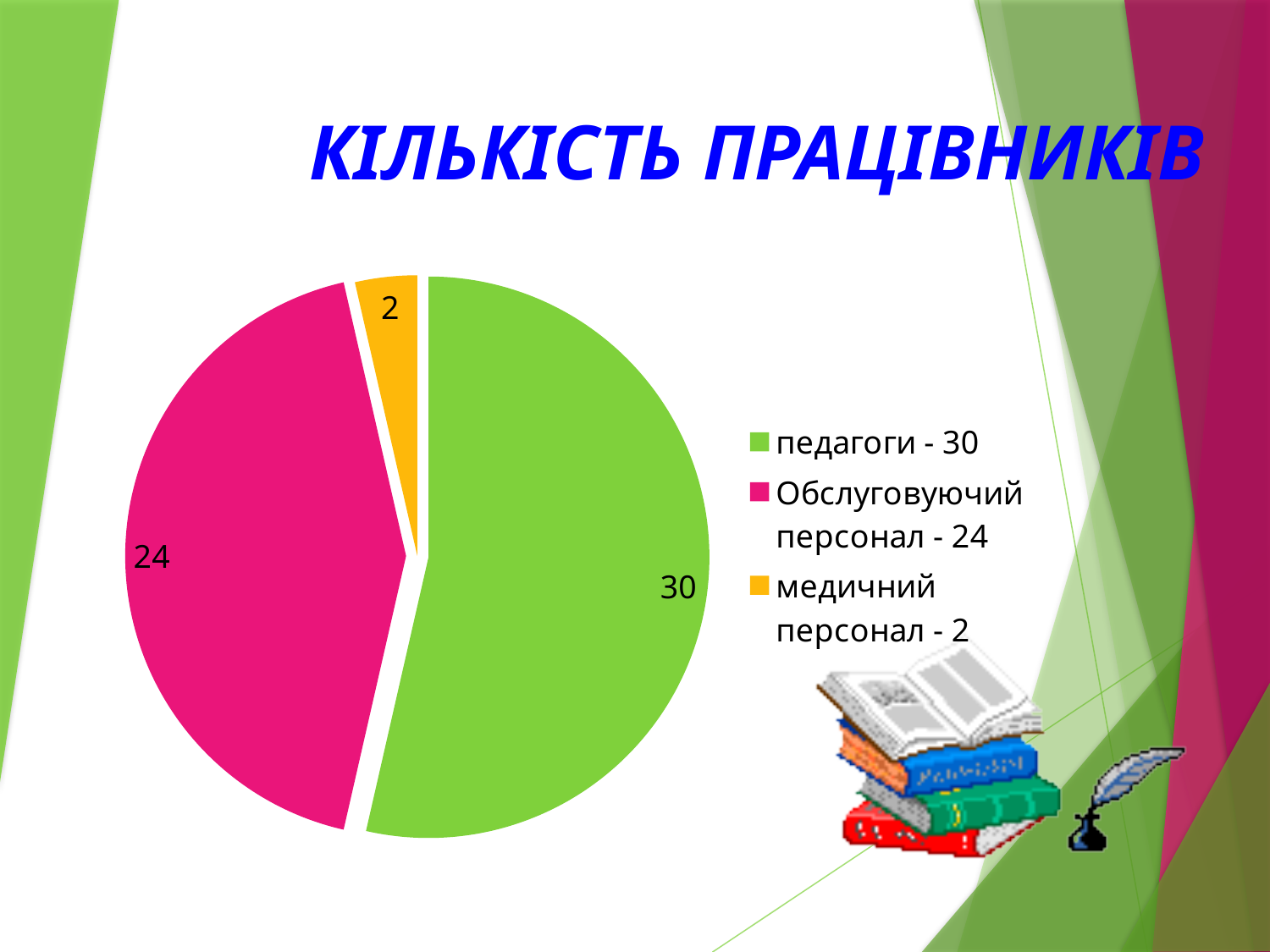
What is the title of the chart? КІЛЬКІСТЬ ПРАЦІВНИКІВ Which category has the smallest slice? медичний персонал Which is larger, the value for Обслуговуючий персонал or the value for медичний персонал? Обслуговуючий персонал What is the value for Обслуговуючий персонал? 24 What is the value for педагоги? 30 Which category has the largest slice? педагоги What is the value for медичний персонал? 2 What colour is the slice for медичний персонал? yellow What is the difference between the values for педагоги and Обслуговуючий персонал? 6 What kind of chart is shown on the slide? pie chart How many entries does the legend list? 3 How many slices does the pie chart have? 3